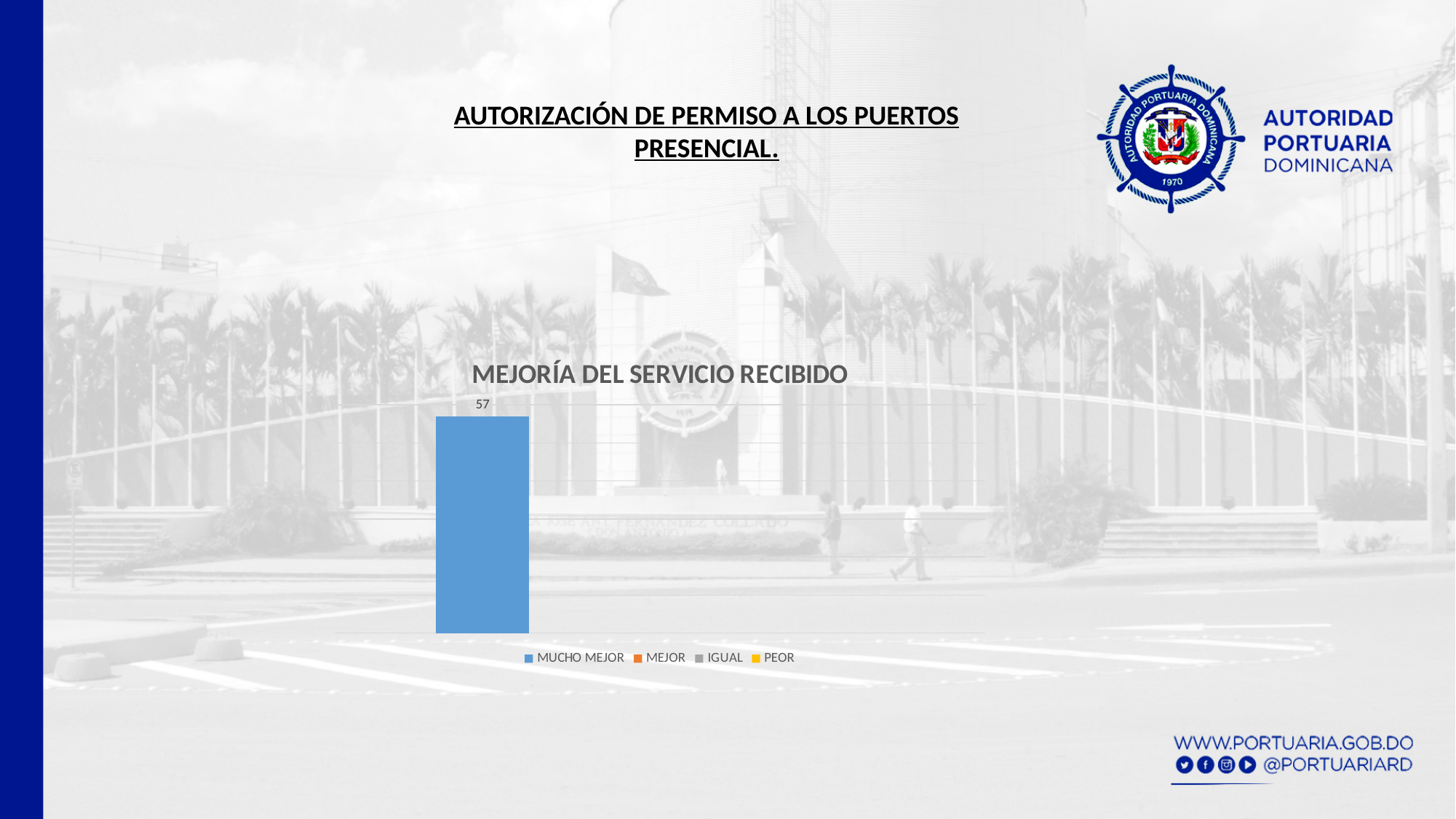
What are the legend entries of the MEJORÍA DEL SERVICIO RECIBIDO chart? MUCHO MEJOR, MEJOR, IGUAL, PEOR How many series does the legend of the MEJORÍA DEL SERVICIO RECIBIDO chart list? 4 What is the value shown for MUCHO MEJOR in the MEJORÍA DEL SERVICIO RECIBIDO chart? 57 What is the title of the chart on the slide? MEJORÍA DEL SERVICIO RECIBIDO Which series has the highest value in the MEJORÍA DEL SERVICIO RECIBIDO chart? MUCHO MEJOR Which series is the only one with a visible bar in the MEJORÍA DEL SERVICIO RECIBIDO chart? MUCHO MEJOR How many bars are visibly plotted in the MEJORÍA DEL SERVICIO RECIBIDO chart? 1 What kind of chart is MEJORÍA DEL SERVICIO RECIBIDO? Bar chart